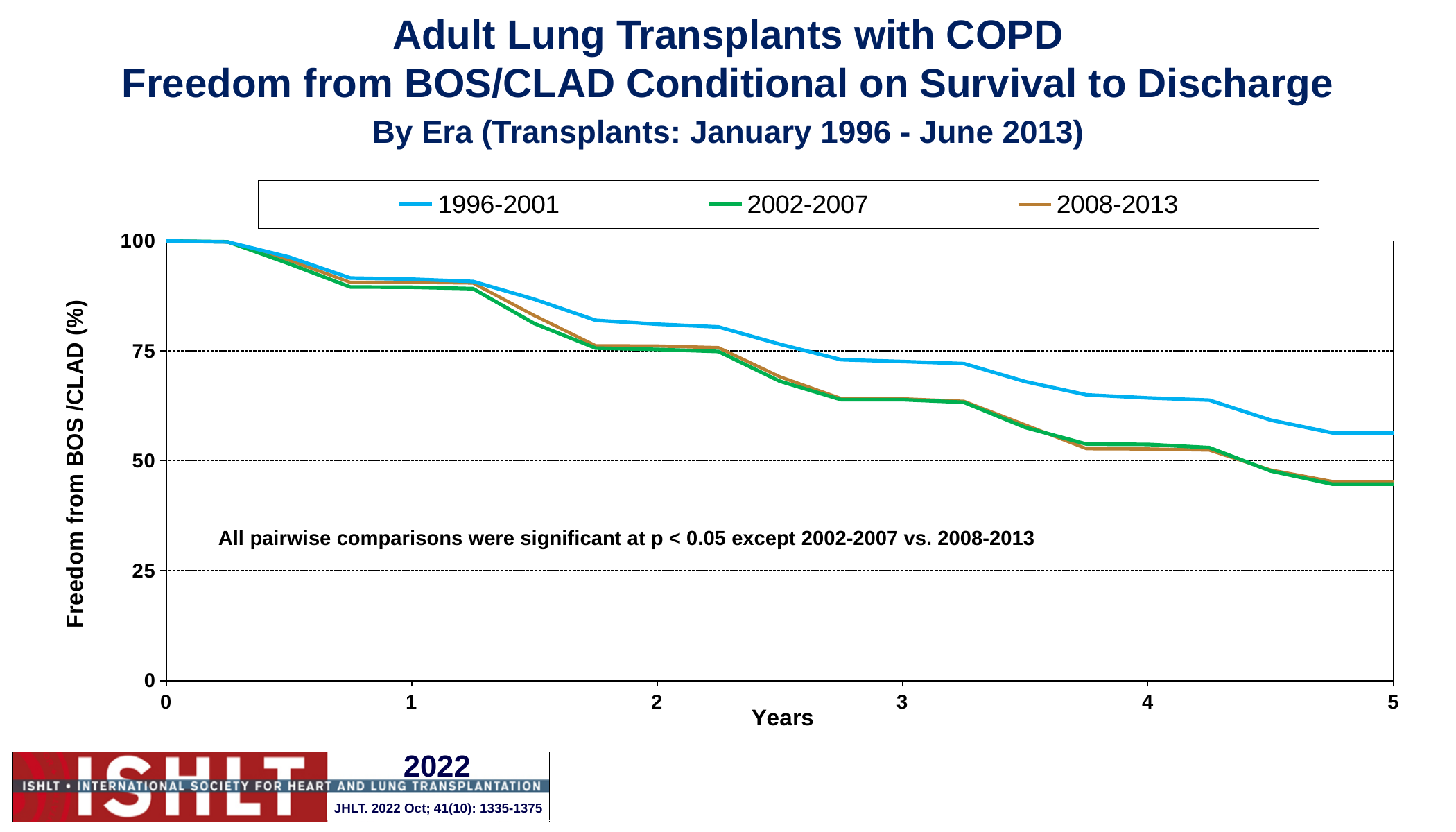
Is the value for the 2002-2007 era at year 5 greater or less than 50? less Is the value for the 1996-2001 era at year 2 greater or less than 75? greater What is the freedom from BOS/CLAD value for the 1996-2001 era at year 0? 100 Do the freedom from BOS/CLAD values rise or fall as years increase? fall How many series does the legend list? 3 At year 5, which era has the larger freedom from BOS/CLAD value: 1996-2001 or 2002-2007? 1996-2001 Is the value for the 1996-2001 era at year 5 greater or less than 50? greater According to the note on the chart, which pairwise comparison was not significant at p < 0.05? 2002-2007 vs. 2008-2013 What kind of chart is shown on the slide? line chart Which eras are listed in the legend? 1996-2001, 2002-2007, 2008-2013 Which era has the highest freedom from BOS/CLAD at year 5? 1996-2001